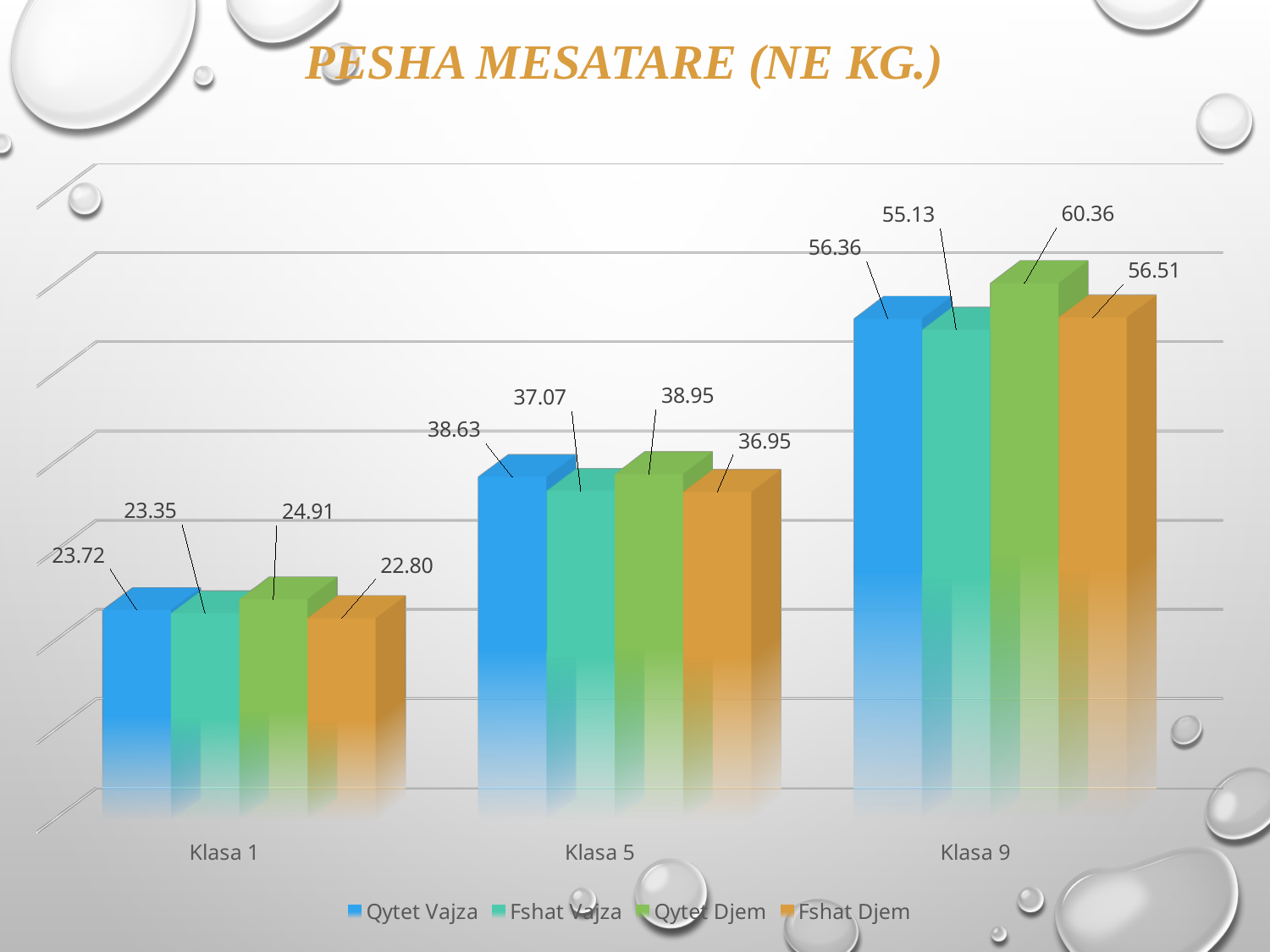
What is the value for Qytet Djem in Klasa 9? 60.36 How many categories are shown on the x axis? 3 What is the value for Fshat Vajza in Klasa 5? 37.07 What is the difference between Qytet Djem and Fshat Vajza in Klasa 9? 5.23 What is the value for Fshat Djem in Klasa 1? 22.80 How many series does the legend list? 4 What kind of chart is shown on the slide? Bar chart Which is larger, Fshat Djem in Klasa 9 or Qytet Vajza in Klasa 9? Fshat Djem Which series has the lowest value in Klasa 1? Fshat Djem Which series has the highest value in Klasa 9? Qytet Djem What is the value for Qytet Vajza in Klasa 9? 56.36 What is the difference between Qytet Vajza in Klasa 5 and Qytet Vajza in Klasa 1? 14.91